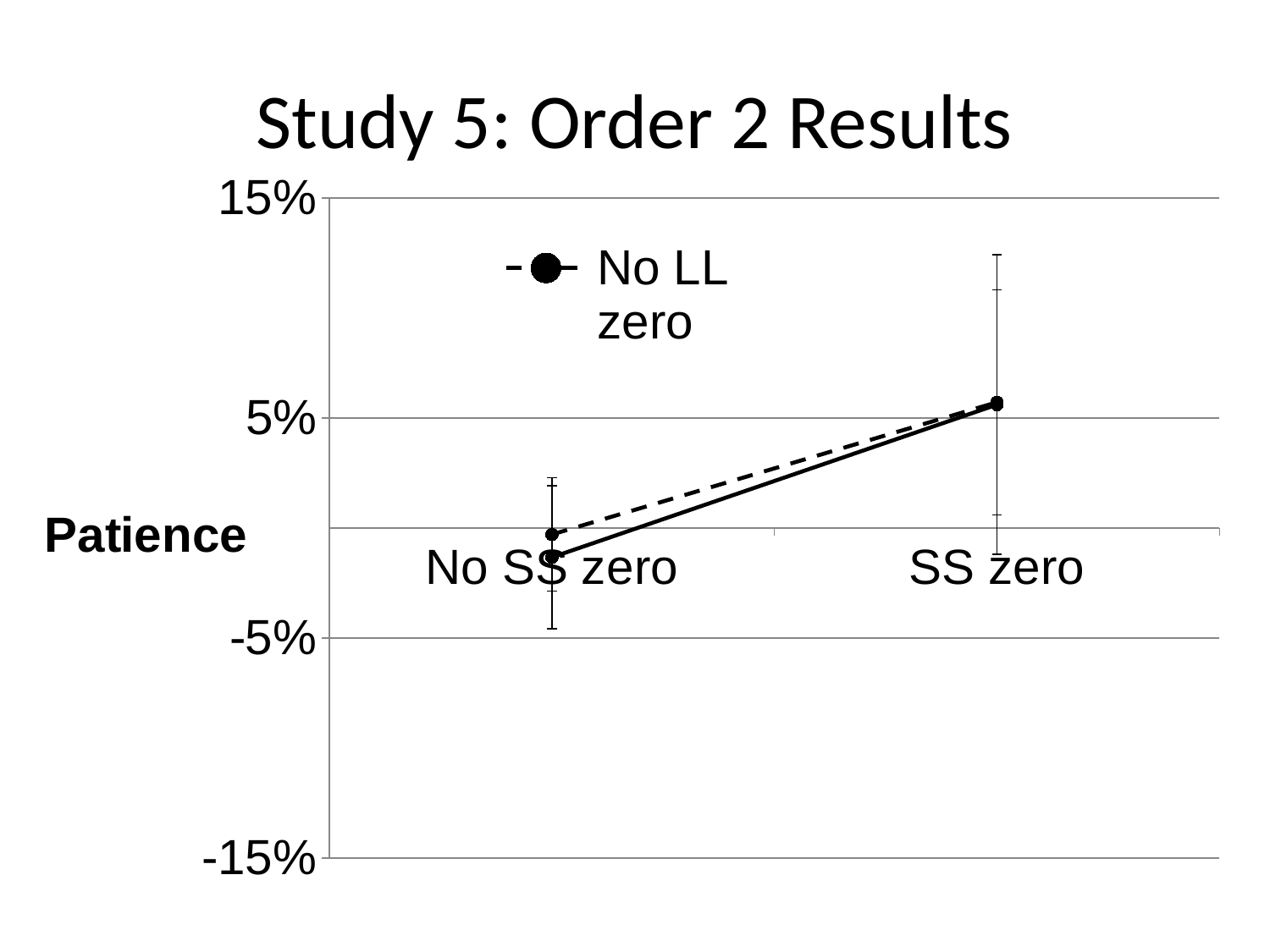
Does the No LL zero series rise or fall from No SS zero to SS zero? rise Is the value for No LL zero at SS zero greater or less than 15%? less Is the value for No LL zero at No SS zero greater or less than -5%? greater For the No LL zero series, which category has the higher value, No SS zero or SS zero? SS zero Is the value for No LL zero at SS zero greater or less than -5%? greater What label is shown on the vertical axis? Patience What is the title of the chart? Study 5: Order 2 Results What is the highest value shown on the vertical axis? 15% For the No LL zero series, which category has the lowest value? No SS zero How many categories are shown on the x axis? 2 What kind of chart is shown on the slide? line chart